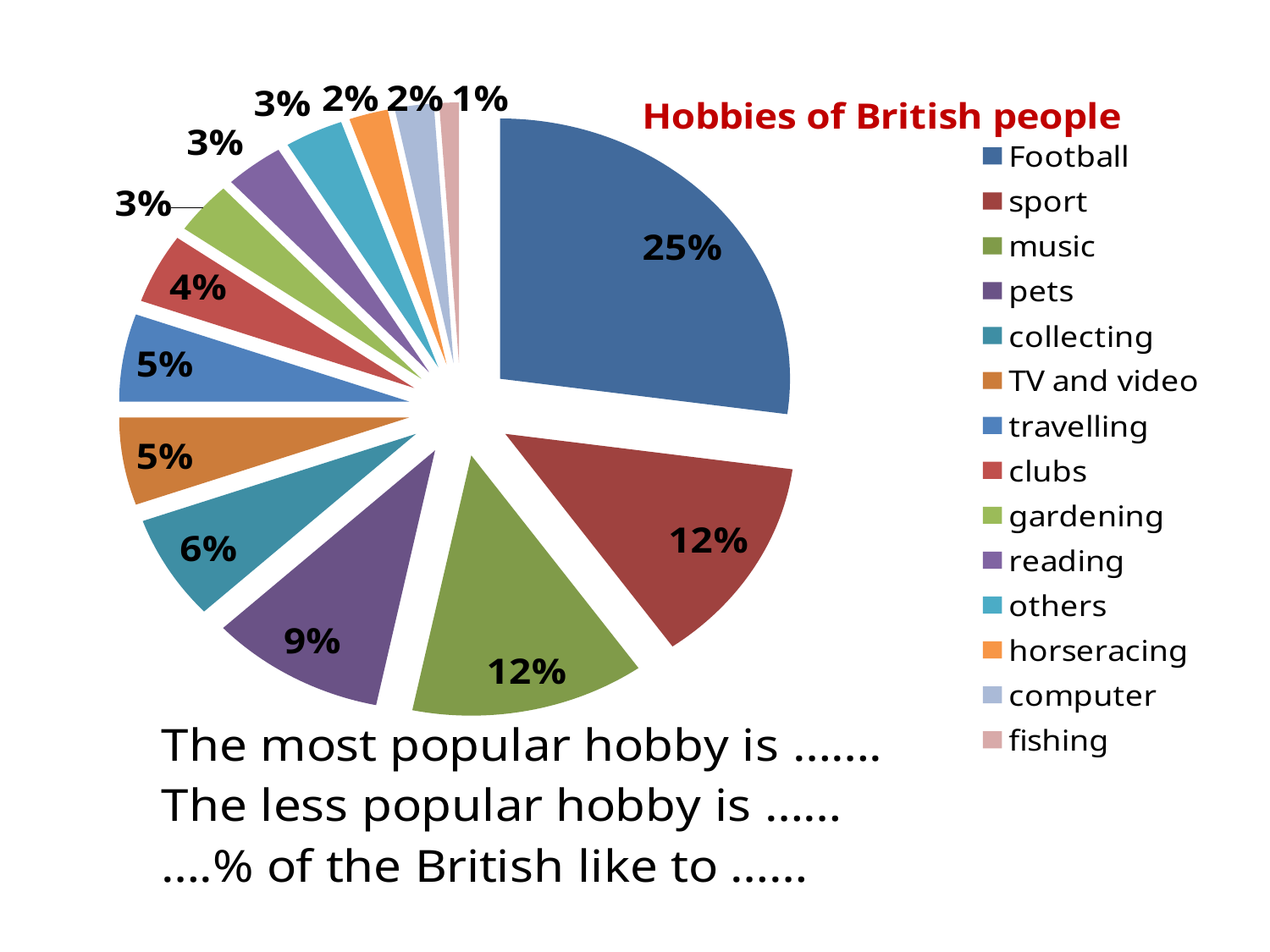
What is the value for clubs in the pie chart? 4% What is the title of the chart? Hobbies of British people What kind of chart is shown on the slide? pie chart Which hobby has the largest slice of the pie chart? Football How many hobbies are listed in the legend of the pie chart? 14 Which hobby has the smallest slice of the pie chart? fishing What is the value for collecting in the pie chart? 6% What is the difference in percentage points between Football and sport? 13 What share of the pie does pets have? 9% What percentage is shown for fishing? 1% Which is larger, the slice for pets or the slice for collecting? pets What percentage of the pie chart is Football? 25%